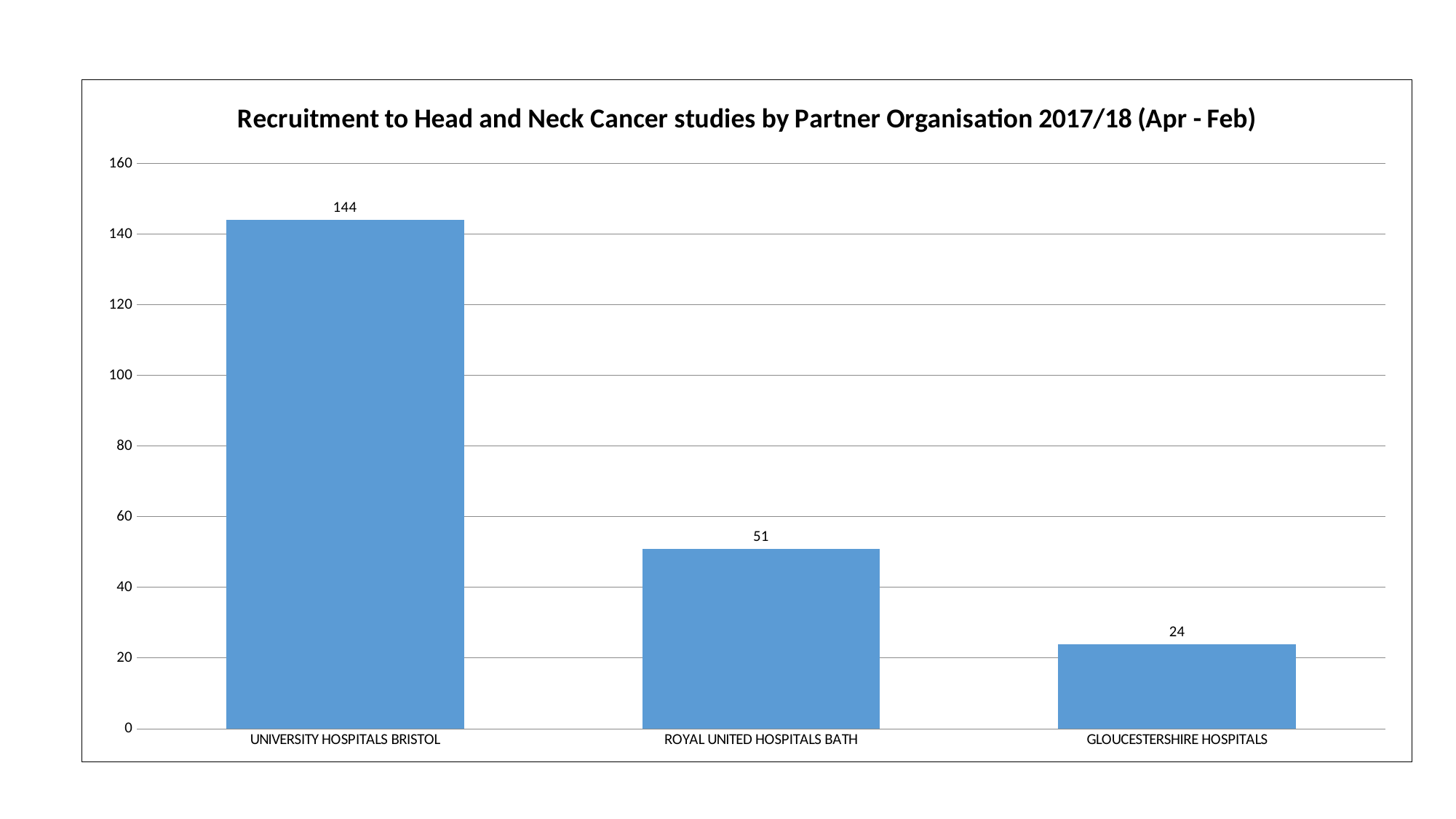
What is the difference in recruitment between University Hospitals Bristol and Royal United Hospitals Bath? 93 What is the difference in recruitment between Royal United Hospitals Bath and Gloucestershire Hospitals? 27 What kind of chart is shown on the slide? Bar chart Which has higher recruitment, Royal United Hospitals Bath or Gloucestershire Hospitals? Royal United Hospitals Bath What is the recruitment value for University Hospitals Bristol? 144 How many partner organisations are shown on the chart? 3 Is the value for Royal United Hospitals Bath greater or less than 60? less What is the recruitment value for Royal United Hospitals Bath? 51 Which partner organisation has the lowest recruitment? Gloucestershire Hospitals What is the title of the chart? Recruitment to Head and Neck Cancer studies by Partner Organisation 2017/18 (Apr - Feb) Which partner organisation has the highest recruitment? University Hospitals Bristol What is the recruitment value for Gloucestershire Hospitals? 24